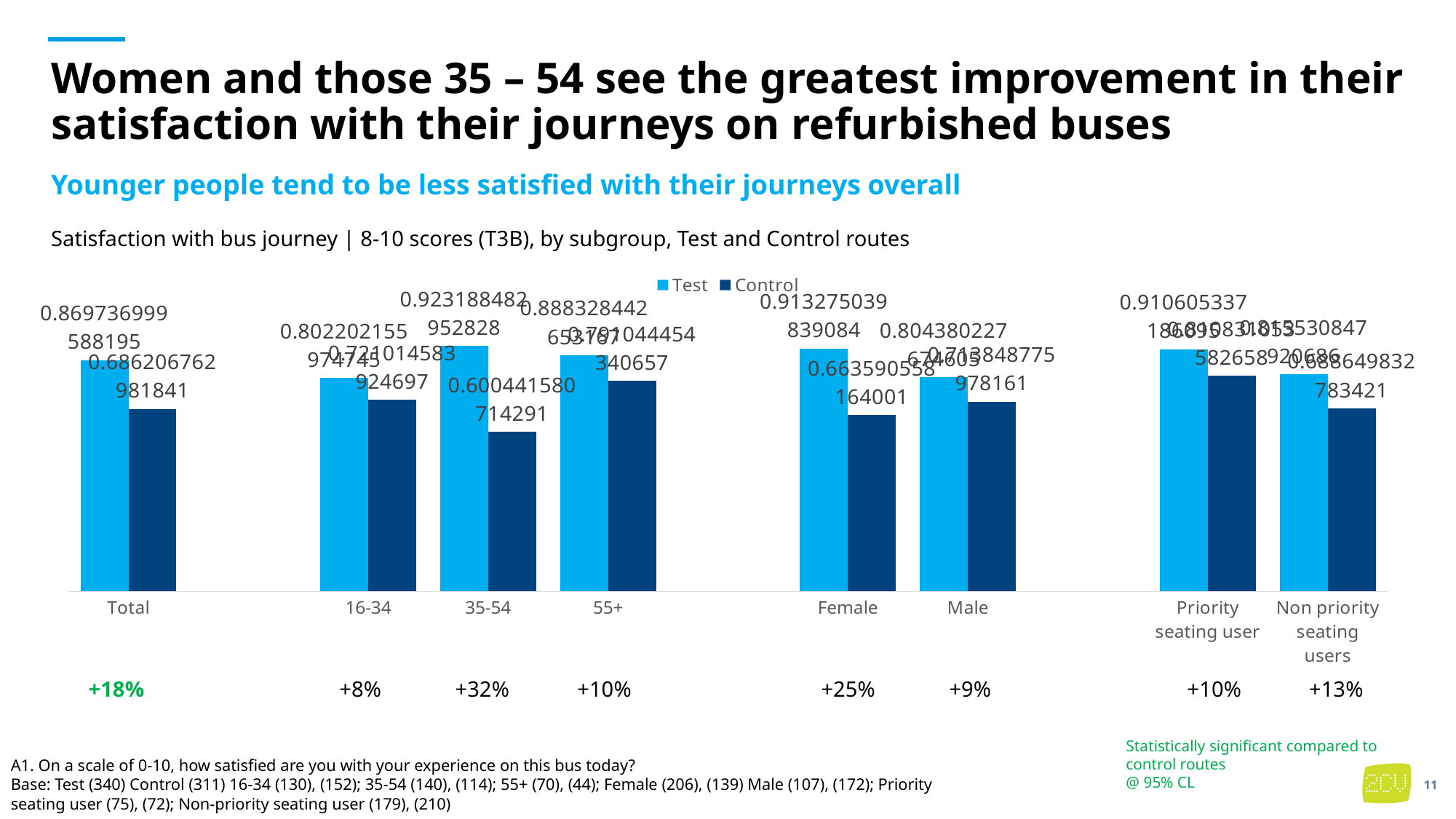
What percentage improvement is shown beneath the 35-54 category? +32% What is the Control value for the Female category? 0.663590558164001 How many subgroup categories are plotted along the x axis? 8 Is the Test value or the Control value larger for the Female category? Test What is the Test value for the Total category? 0.869736999588195 Which subgroup shows the smallest percentage improvement beneath the chart? 16-34 How many series does the legend list? 2 What is the Control value for the Total category? 0.686206762981841 What kind of chart is shown on the slide? bar chart Which category has the lowest Control value? 35-54 What are the two series named in the legend? Test and Control What is the Control value for the 35-54 category? 0.600441580714291